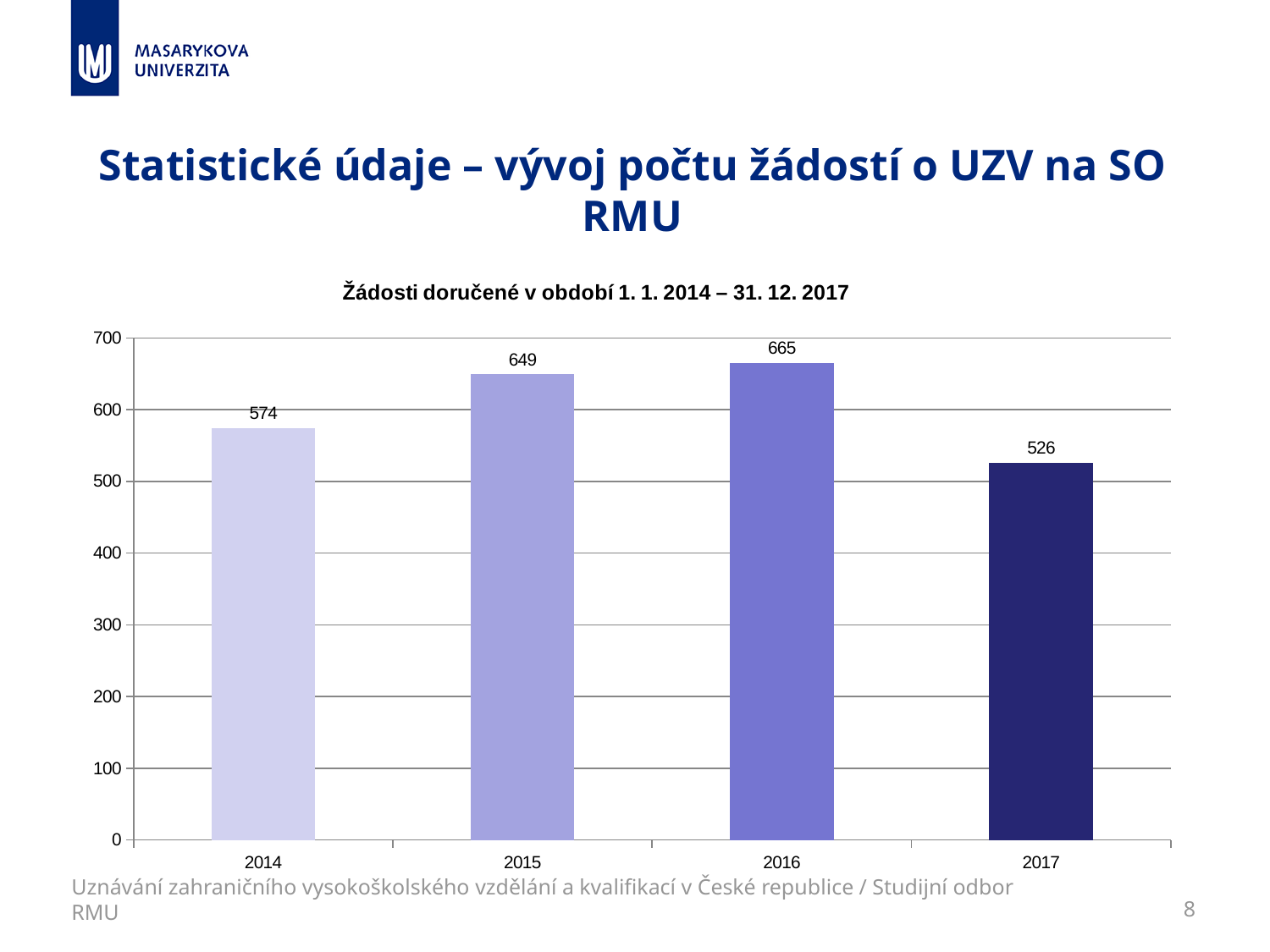
What is the difference between the values for 2016 and 2017? 139 Which year has the lowest value? 2017 What kind of chart is shown? bar chart How many years are shown on the x axis? 4 What is the title of the chart? Žádosti doručené v období 1. 1. 2014 – 31. 12. 2017 What is the difference between the values for 2015 and 2014? 75 Is the value for 2017 greater or less than 600? less Do the values rise or fall from 2016 to 2017? fall What is the value for 2017? 526 Which is larger, the value for 2015 or the value for 2014? 2015 What is the value for 2014? 574 Which year has the highest value? 2016